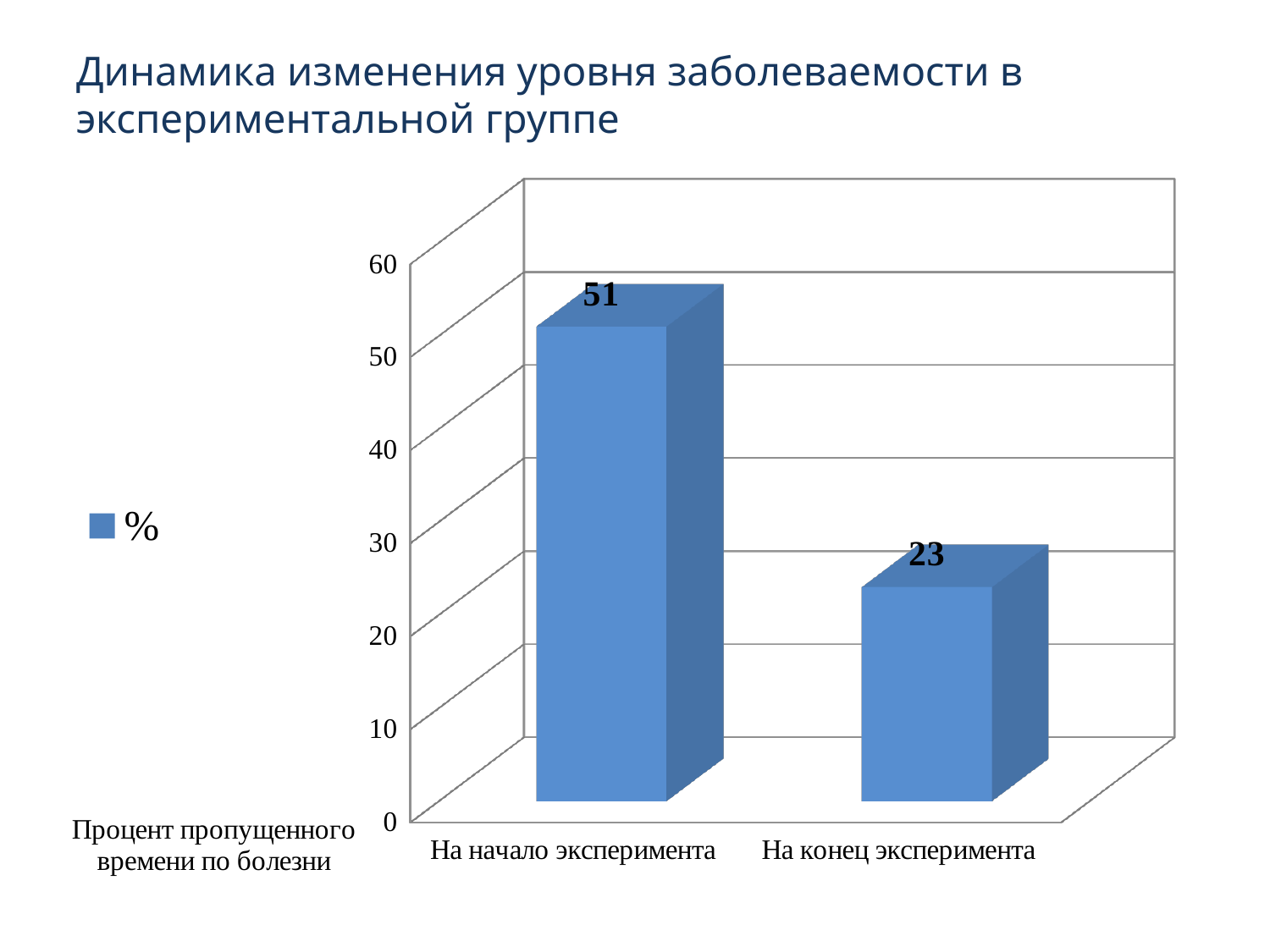
Is the value for "На конец эксперимента" greater or less than 30? less How many categories are shown on the x axis? 2 How many series does the legend list? 1 Which category has the lowest value? На конец эксперимента What kind of chart is shown on the slide? bar chart What is the value for "На конец эксперимента"? 23 Which category has the highest value? На начало эксперимента What is the value for "На начало эксперимента"? 51 Is the value for "На начало эксперимента" greater or less than 40? greater Do the values rise or fall from the start to the end of the experiment? fall What is the difference between the values for "На начало эксперимента" and "На конец эксперимента"? 28 Which is larger: the value for "На начало эксперимента" or for "На конец эксперимента"? На начало эксперимента